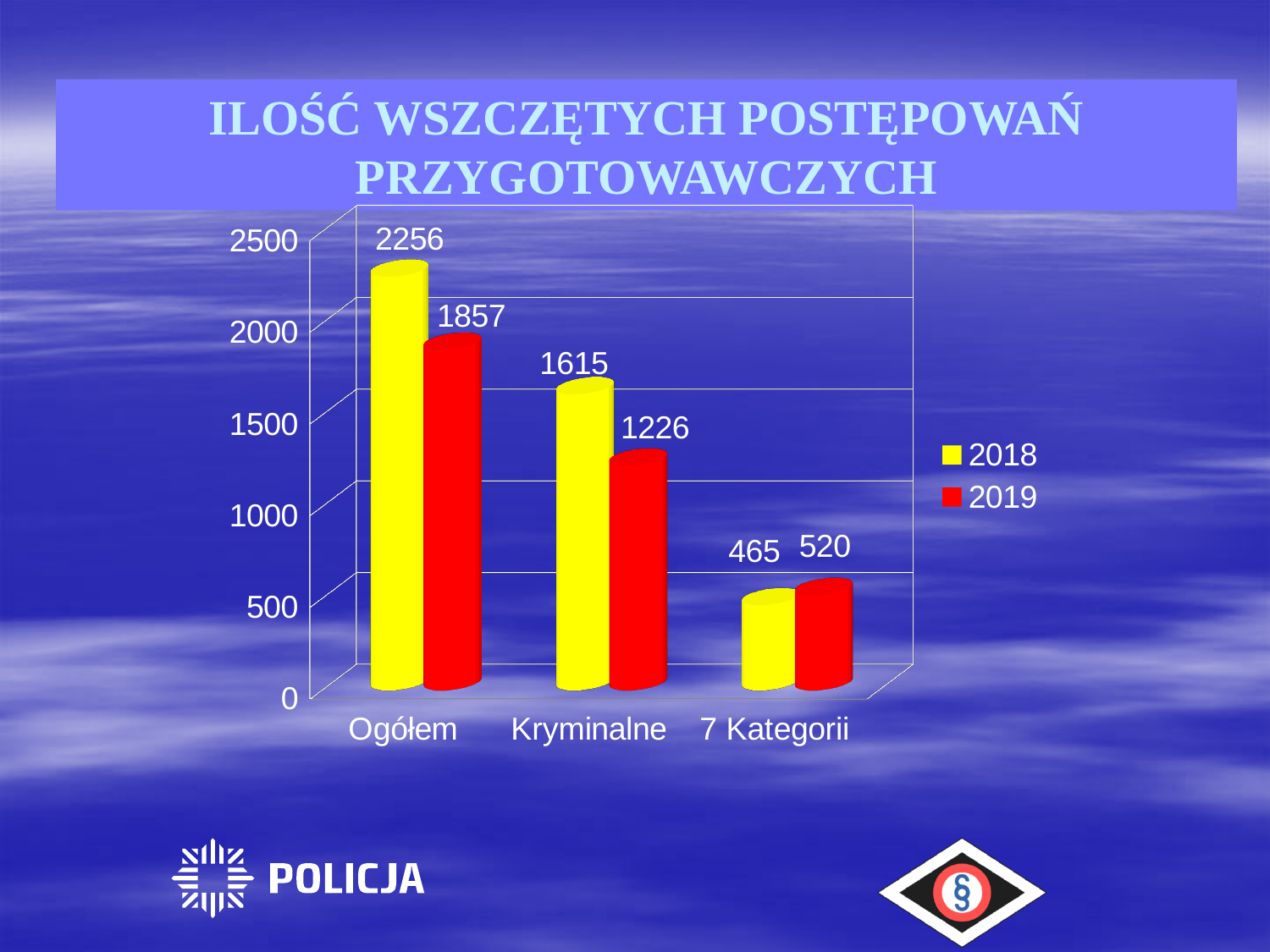
How many categories are shown on the x axis? 3 What kind of chart is shown on the slide? bar chart What is the value for Ogółem in 2018? 2256 Which category has the lowest value in 2018? 7 Kategorii What is the difference between the 2019 and 2018 values for 7 Kategorii? 55 How many series does the legend list? 2 What is the value for 7 Kategorii in 2018? 465 Which is larger for Kryminalne, the 2018 value or the 2019 value? 2018 What is the value for Kryminalne in 2019? 1226 What is the difference between the 2018 and 2019 values for Ogółem? 399 Which colour represents the 2019 series? red Which category has the highest value in 2019? Ogółem